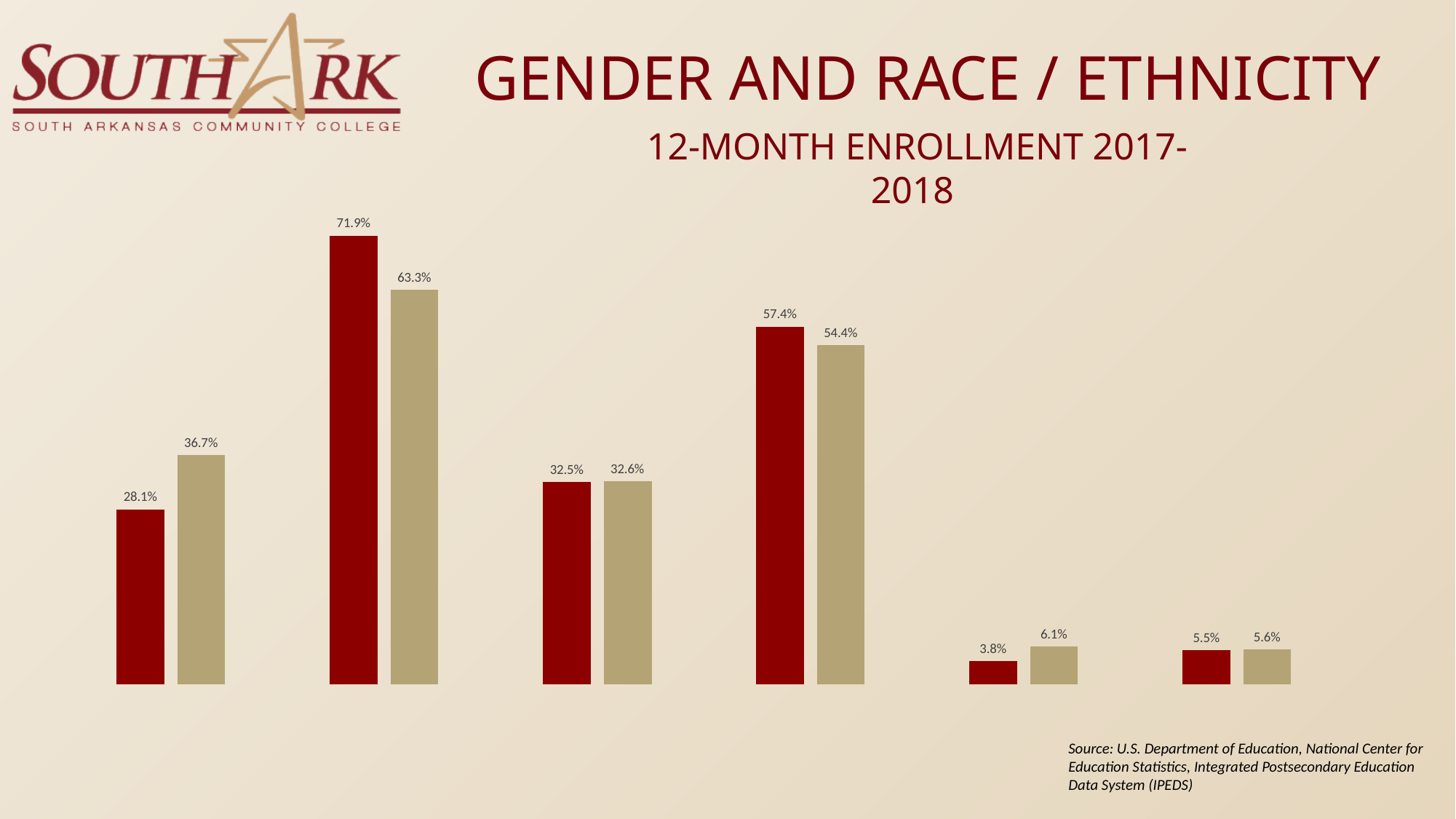
What is the value of the dark red bar in the fourth group from the left? 57.4% In the second group from the left, what is the difference between the dark red bar (71.9%) and the tan bar (63.3%)? 8.6 percentage points What kind of chart is shown on the slide? Bar chart How many bars are in each group of the chart? 2 How many groups of bars are plotted in the chart? 6 What is the lowest value labelled on the chart? 3.8% What is the value of the dark red bar in the leftmost group? 28.1% In the fifth group from the left, what is the difference between the tan bar (6.1%) and the dark red bar (3.8%)? 2.3 percentage points In the leftmost group, which bar is larger, the dark red bar or the tan bar? The tan bar What is the highest value labelled on the chart? 71.9% What is the value of the tan bar in the second group from the left? 63.3%